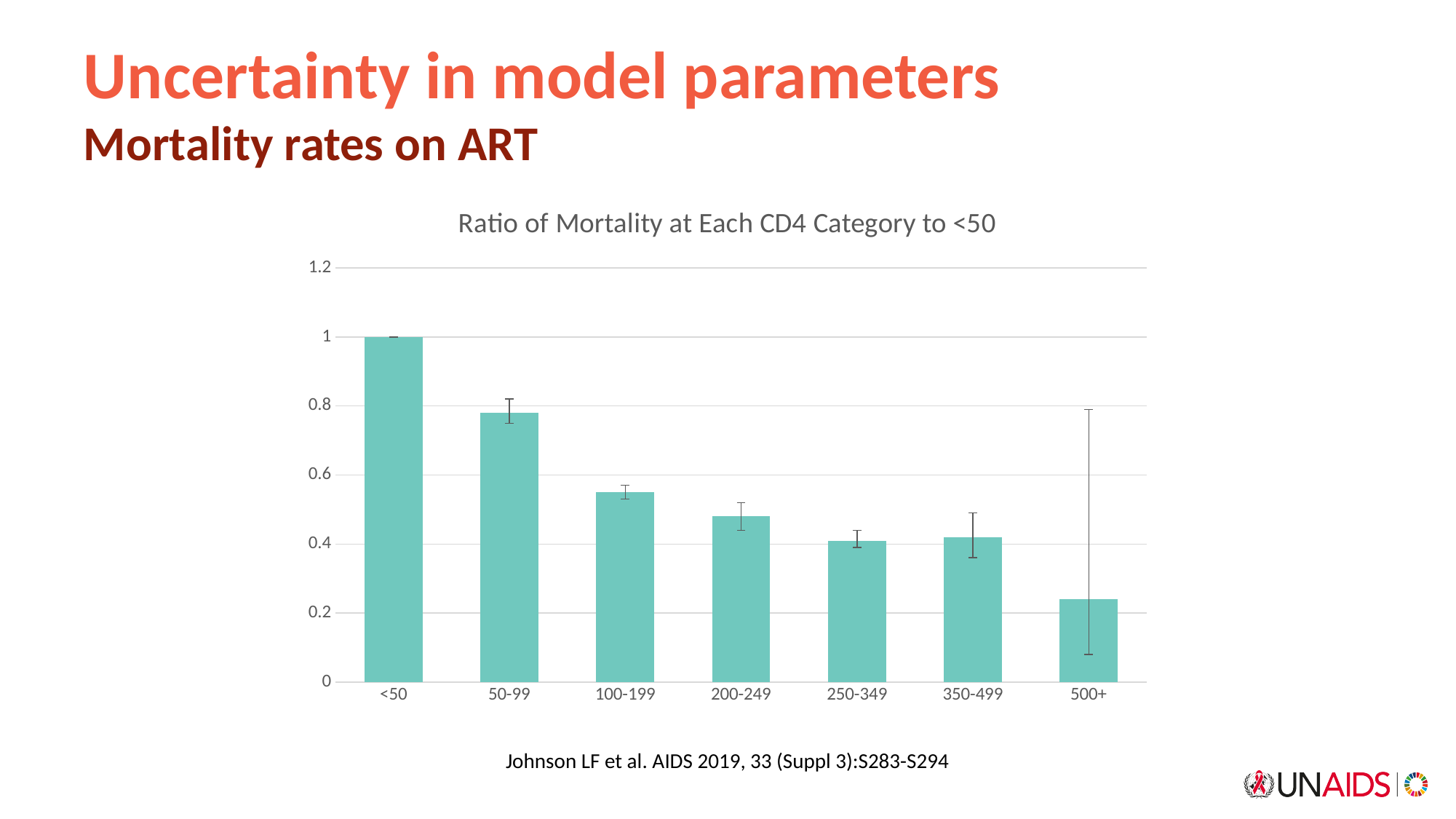
What is the mortality ratio for the <50 CD4 category? 1 Which CD4 category has the lowest mortality ratio? 500+ Is the mortality ratio for the 100-199 category greater or less than 0.6? less Which CD4 category has the highest mortality ratio? <50 Do the mortality ratios generally rise or fall as the CD4 category increases along the x axis? fall Which has a higher mortality ratio, the 50-99 category or the 100-199 category? 50-99 How many CD4 categories are shown on the x axis? 7 Is the mortality ratio for the 200-249 category greater or less than 0.4? greater Is the mortality ratio for the 50-99 category greater or less than 0.6? greater What is the title of the chart? Ratio of Mortality at Each CD4 Category to <50 What type of chart is shown on the slide? bar chart